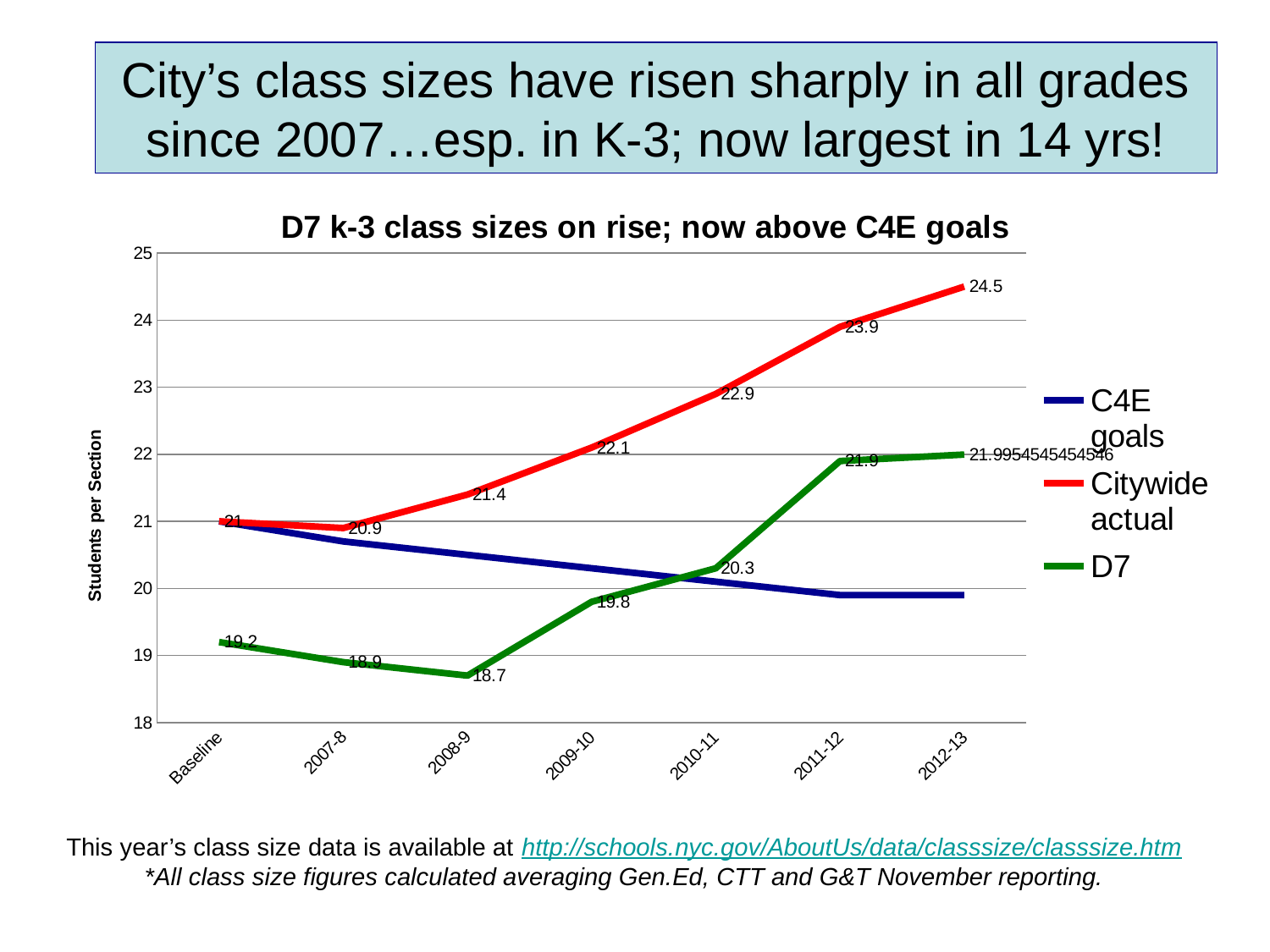
In which year is the D7 value lowest? 2008-9 What is the Citywide actual value for 2012-13? 24.5 In which year is the Citywide actual value highest? 2012-13 What is the D7 value for 2008-9? 18.7 Does the Citywide actual series rise or fall from 2007-8 to 2012-13? rise In 2011-12, which is larger: the Citywide actual value or the D7 value? Citywide actual How many points are plotted along the x axis for each series? 7 What is the difference between the Citywide actual value in 2012-13 and at Baseline? 3.5 How many series does the legend list? 3 What is the difference between the D7 values for 2011-12 and 2010-11? 1.6 What kind of chart is shown on the slide? line chart